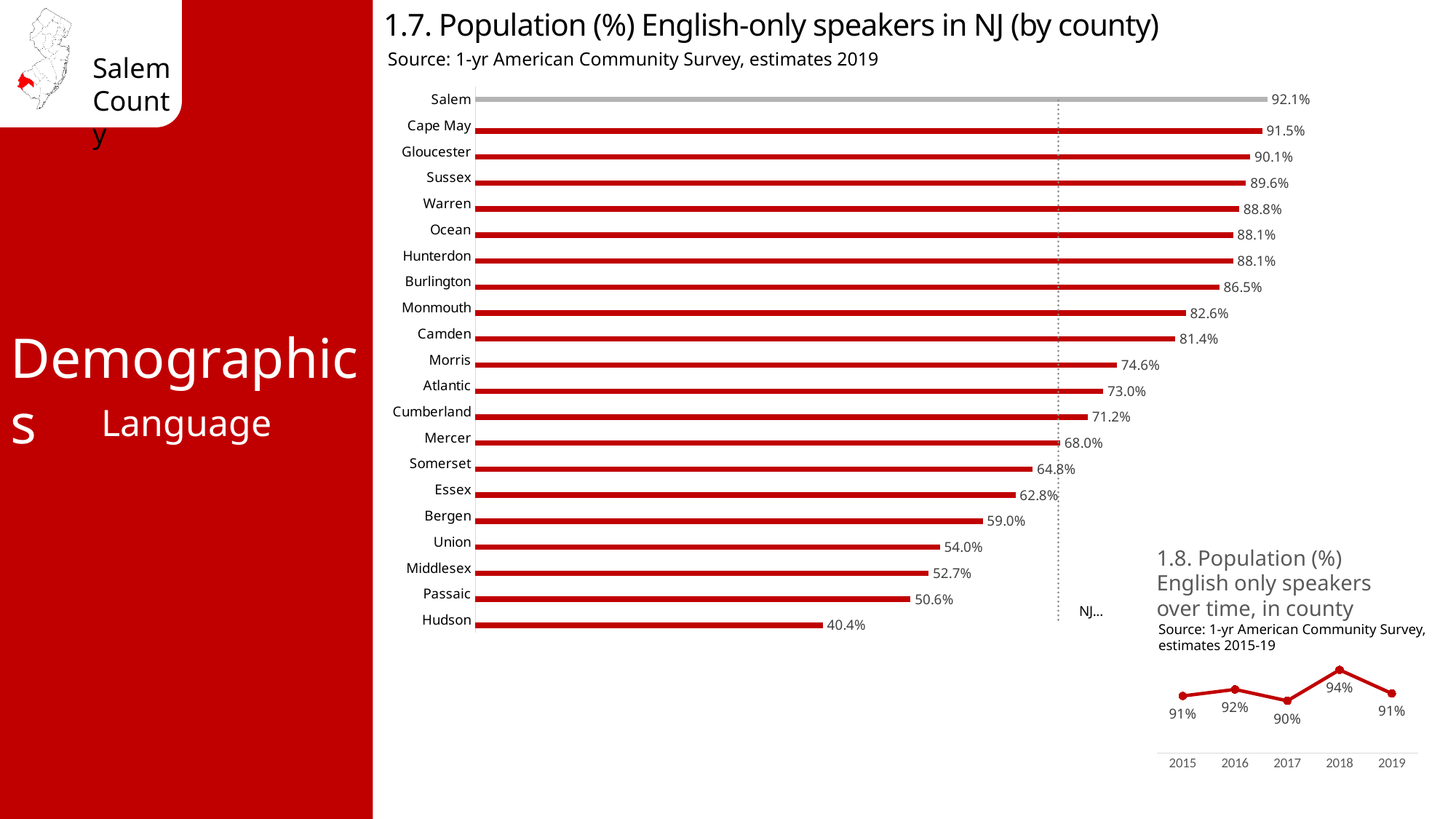
How many counties are shown in the chart '1.7. Population (%) English-only speakers in NJ (by county)'? 21 In the chart '1.8. Population (%) English only speakers over time, in county', what is the value for 2018? 94% In the chart '1.7. Population (%) English-only speakers in NJ (by county)', which is larger, Morris or Atlantic? Morris In the chart '1.7. Population (%) English-only speakers in NJ (by county)', what is the value for Hudson? 40.4% In the chart '1.7. Population (%) English-only speakers in NJ (by county)', which county has the lowest value? Hudson In the chart '1.7. Population (%) English-only speakers in NJ (by county)', what is the value for Salem? 92.1% In the chart '1.7. Population (%) English-only speakers in NJ (by county)', what is the value for Cumberland? 71.2% What kind of chart is '1.8. Population (%) English only speakers over time, in county'? Line chart What kind of chart is '1.7. Population (%) English-only speakers in NJ (by county)'? Bar chart In the chart '1.7. Population (%) English-only speakers in NJ (by county)', which county has the highest value? Salem In the chart '1.8. Population (%) English only speakers over time, in county', which year has the lowest value? 2017 In the chart '1.7. Population (%) English-only speakers in NJ (by county)', what is the difference between Salem and Hudson? 51.7%